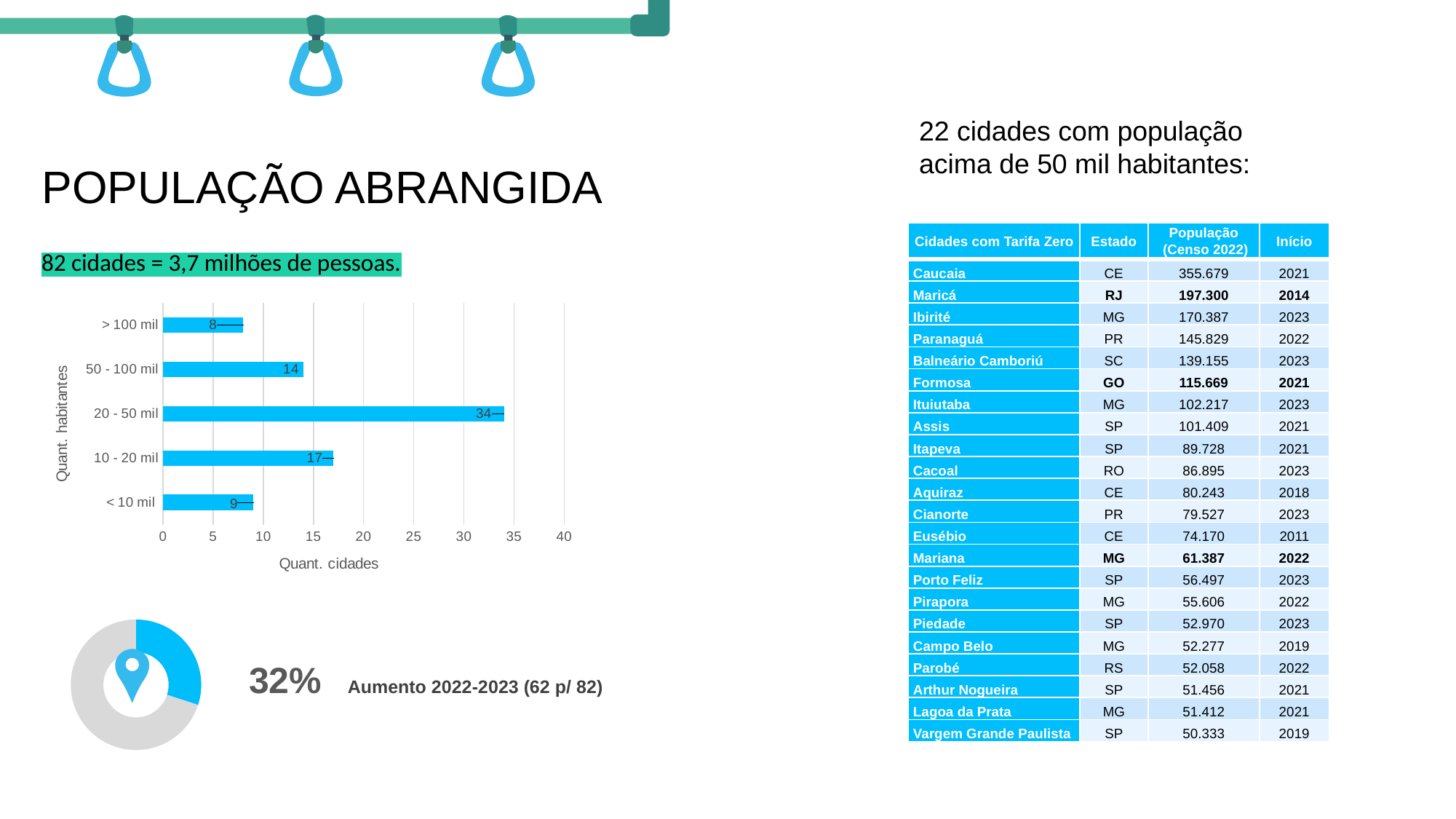
In the bar chart, which population category has the highest number of cities? 20 - 50 mil What type of chart is used to show the number of cities by population range? Bar chart In the bar chart, is the value for '50 - 100 mil' greater or less than 10? greater In the bar chart, what is the value for the '10 - 20 mil' category? 17 In the bar chart, what is the value for the '> 100 mil' category? 8 What percentage is shown in the donut chart at the bottom left of the slide? 32% How many population categories are shown in the bar chart? 5 In the bar chart, which has more cities: '50 - 100 mil' or '< 10 mil'? 50 - 100 mil What is the label of the horizontal axis of the bar chart? Quant. cidades In the bar chart, what is the difference between the '20 - 50 mil' and '10 - 20 mil' values? 17 In the bar chart, how many cities are in the '20 - 50 mil' category? 34 In the bar chart, which population category has the lowest number of cities? > 100 mil